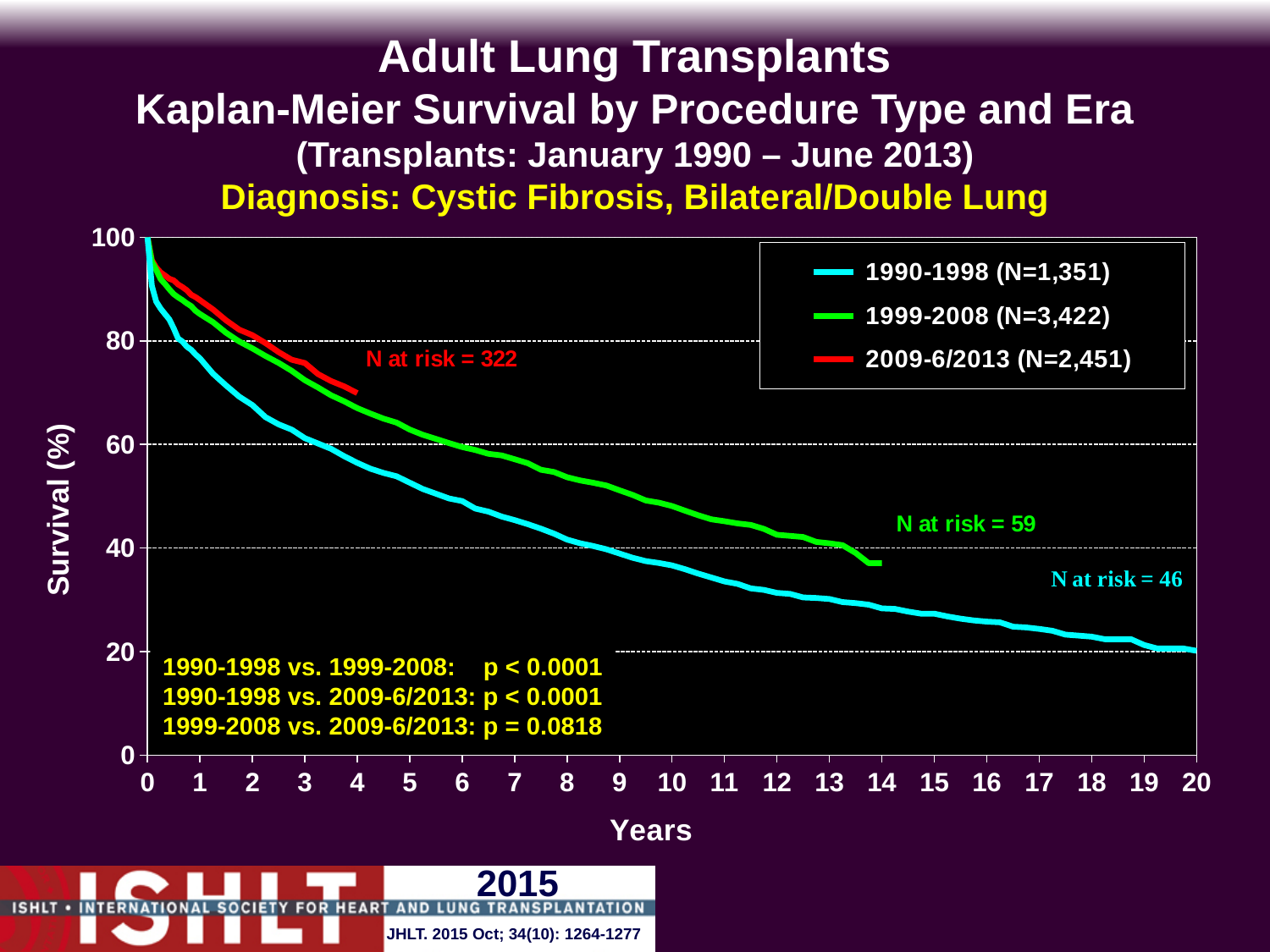
Which era has the lowest survival at 3 years? 1990-1998 How many series does the legend list? 3 What is the N at risk value printed for the 1990-1998 curve? 46 What is the N for the 2009-6/2013 era shown in the legend? 2,451 Do the survival curves rise or fall as years increase? fall Is the survival for the 1999-2008 era at 5 years greater or less than 60? greater Which era has the largest number of transplants (N) in the legend? 1999-2008 What kind of chart is shown on the slide? line chart What is the N for the 1999-2008 era shown in the legend? 3,422 Is the survival for the 1990-1998 era at 10 years greater or less than 40? less At 5 years, which curve shows higher survival: 1990-1998 or 1999-2008? 1999-2008 What is the N at risk value printed for the 2009-6/2013 curve? 322